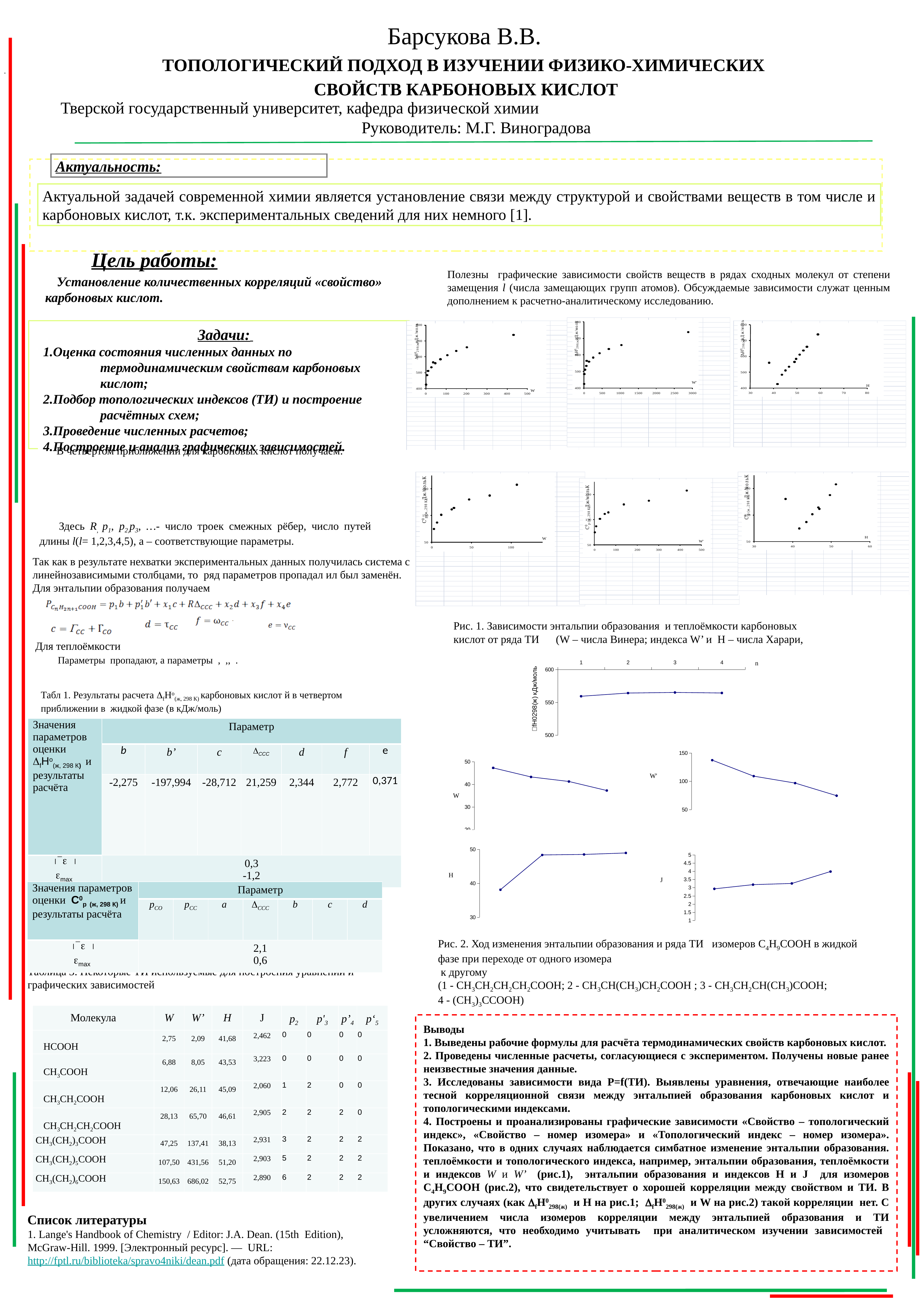
In Fig. 2, is the W' value for isomer 4 greater or less than 100? less In Fig. 2, how many points (isomers) are plotted on the top enthalpy chart? 4 In Fig. 2, does the W' index rise or fall from isomer 1 to isomer 4? fall In Fig. 2, does the W index rise or fall from isomer 1 to isomer 4? fall In Fig. 2, what kind of chart is the W chart (middle-left)? line chart In Fig. 1, does the enthalpy of formation in the top-left chart rise or fall as W increases? rise In Fig. 2, is the J value for isomer 1 greater or less than 3.5? less In Fig. 1, what kind of charts are shown (e.g. the top-left chart plotted against W)? scatter plot In Fig. 2, is the W value for isomer 1 greater or less than 40? greater